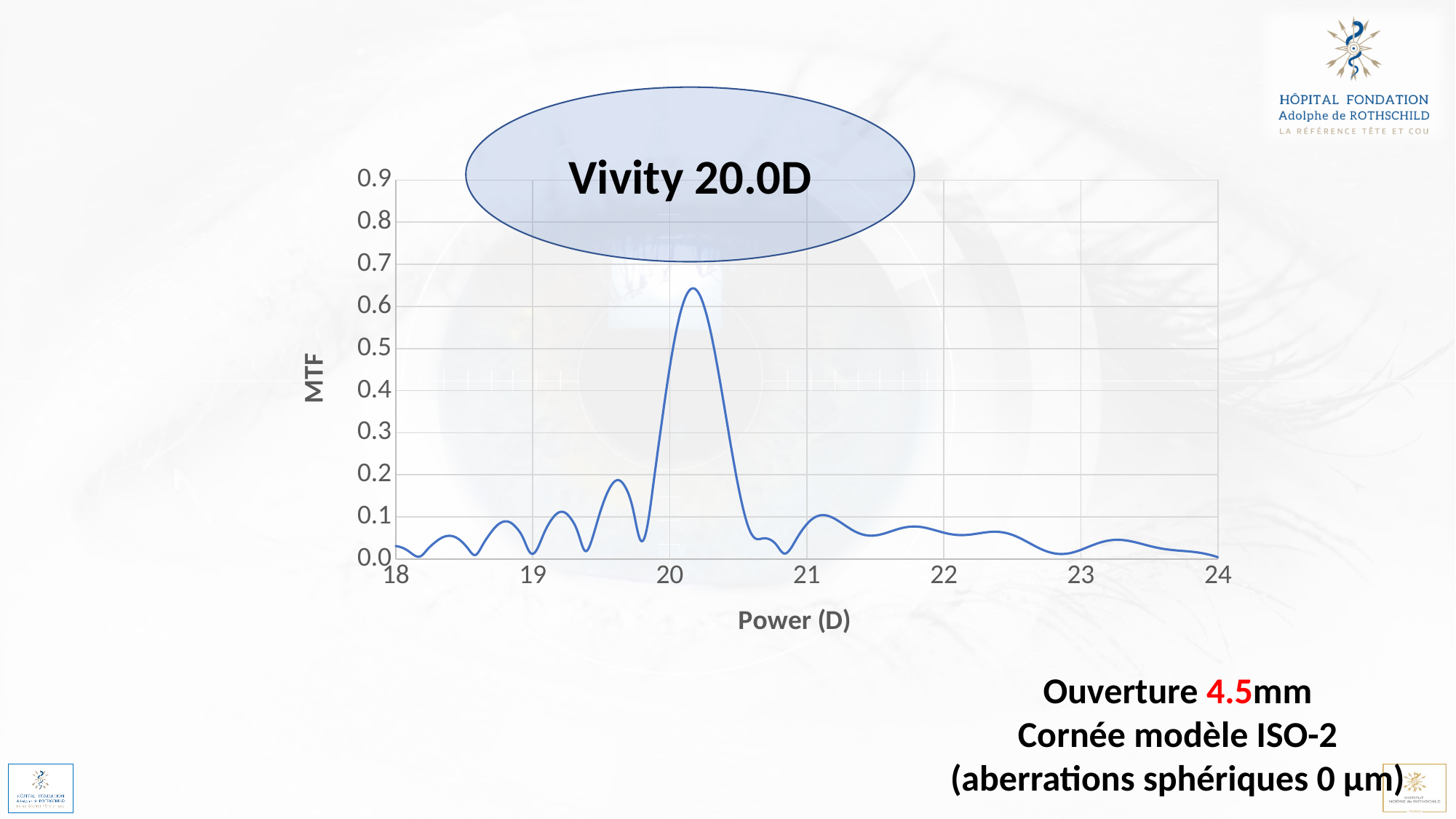
What is the label of the vertical axis of the chart? MTF Does the MTF curve generally rise or fall between 21 D and 24 D? fall What kind of chart is shown on the slide? line chart What is the highest value shown on the vertical axis? 0.9 How many data series are plotted on the chart? 1 Is the peak MTF value of the curve greater or less than 0.5? greater Is the peak MTF value of the curve greater or less than 0.7? less Between which two x-axis tick values does the highest peak of the curve occur? 20 and 21 Is the MTF value at a power of 24 D greater or less than 0.1? less What is the title shown above the chart? Vivity 20.0D How many tick values are labelled on the Power (D) axis? 7